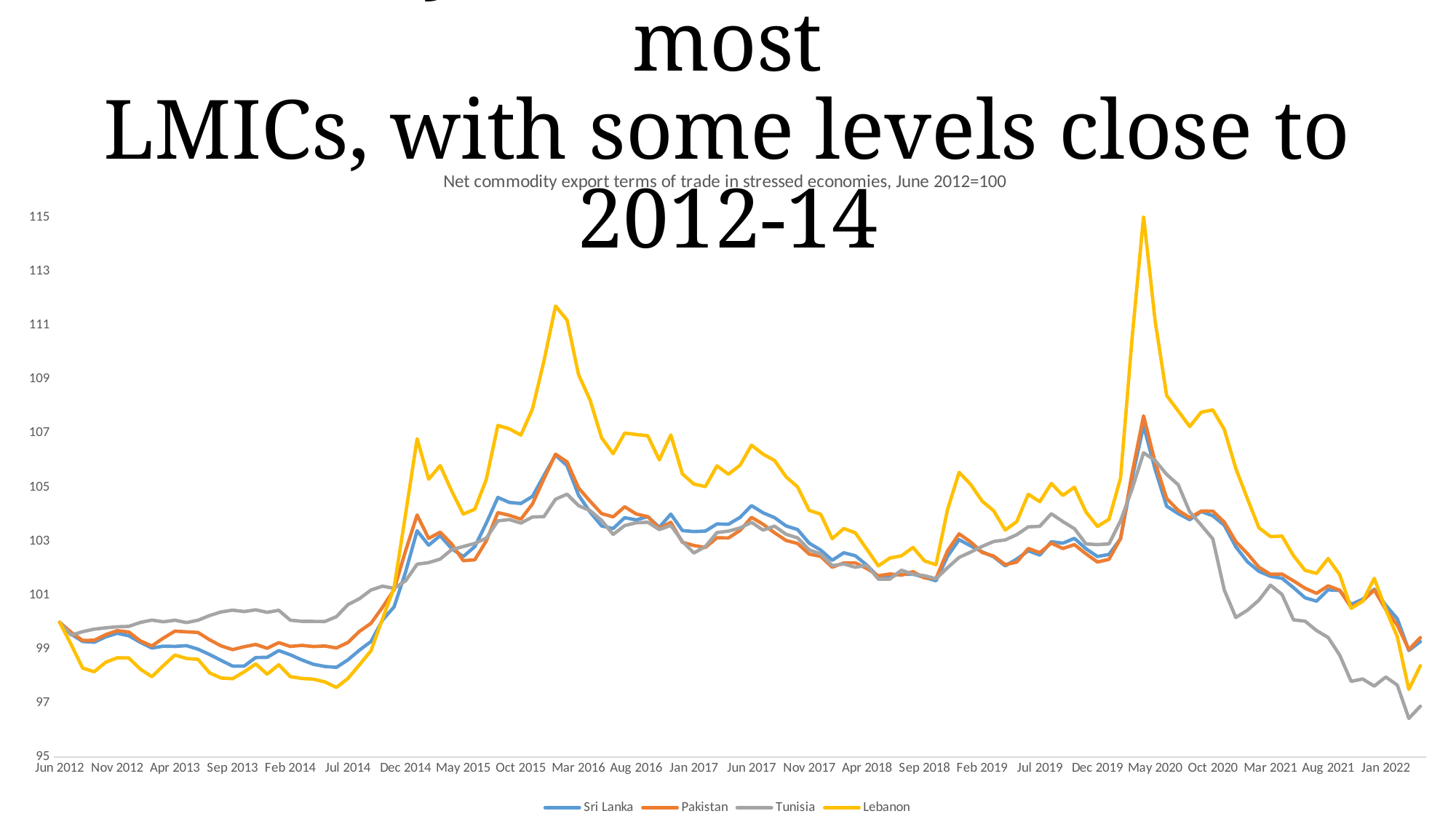
Is the value for Tunisia at the end of the series (early 2022) greater or less than 99? less Around Mar 2016, which series is higher, Lebanon or Tunisia? Lebanon What kind of chart is shown on the slide? line chart Which series is drawn in yellow? Lebanon What is the title of the chart? Net commodity export terms of trade in stressed economies, June 2012=100 How many series does the legend list? 4 Is the value for Lebanon around Jul 2014 greater or less than 99? less Does the Tunisia series rise or fall between Oct 2020 and Jan 2022? fall Is the peak value for Lebanon around May 2020 greater or less than 113? greater Which series reaches the highest value on the chart? Lebanon Which series has the lowest value at the right-hand end of the chart (early 2022)? Tunisia